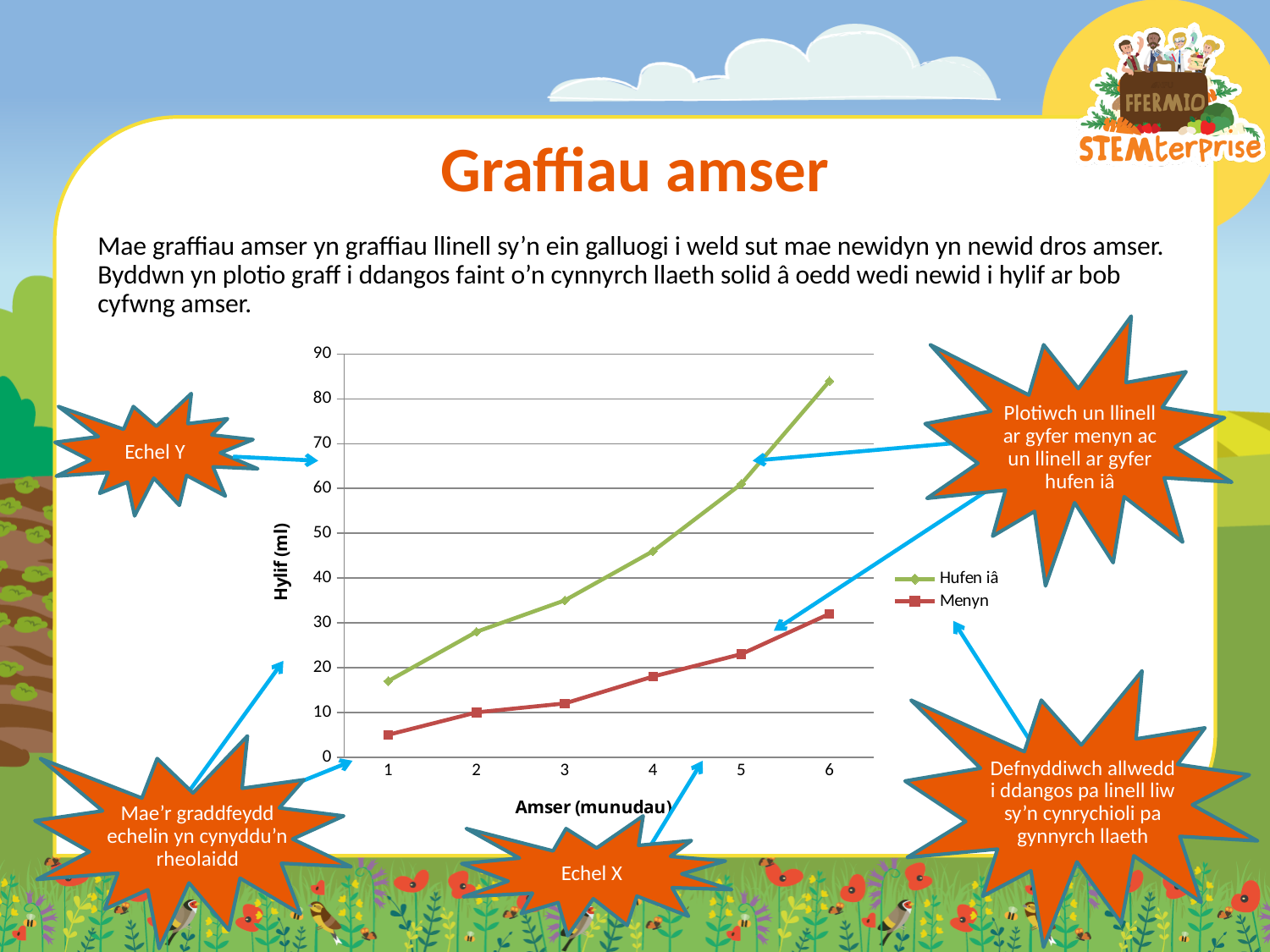
Which two series are listed in the chart's legend? Hufen iâ and Menyn How many time points are plotted along the x axis of the chart? 6 What kind of chart is shown on the slide? line chart At which minute does the Hufen iâ series reach its highest value? 6 Is the value for Hufen iâ at minute 6 greater or less than 80? greater Do the values for Hufen iâ rise or fall as time increases along the x axis? rise What is the title of the chart's y axis? Hylif (ml) How many series does the chart's legend list? 2 At minute 6, which series has the larger value, Hufen iâ or Menyn? Hufen iâ Is the value for Hufen iâ at minute 1 greater or less than 20? less